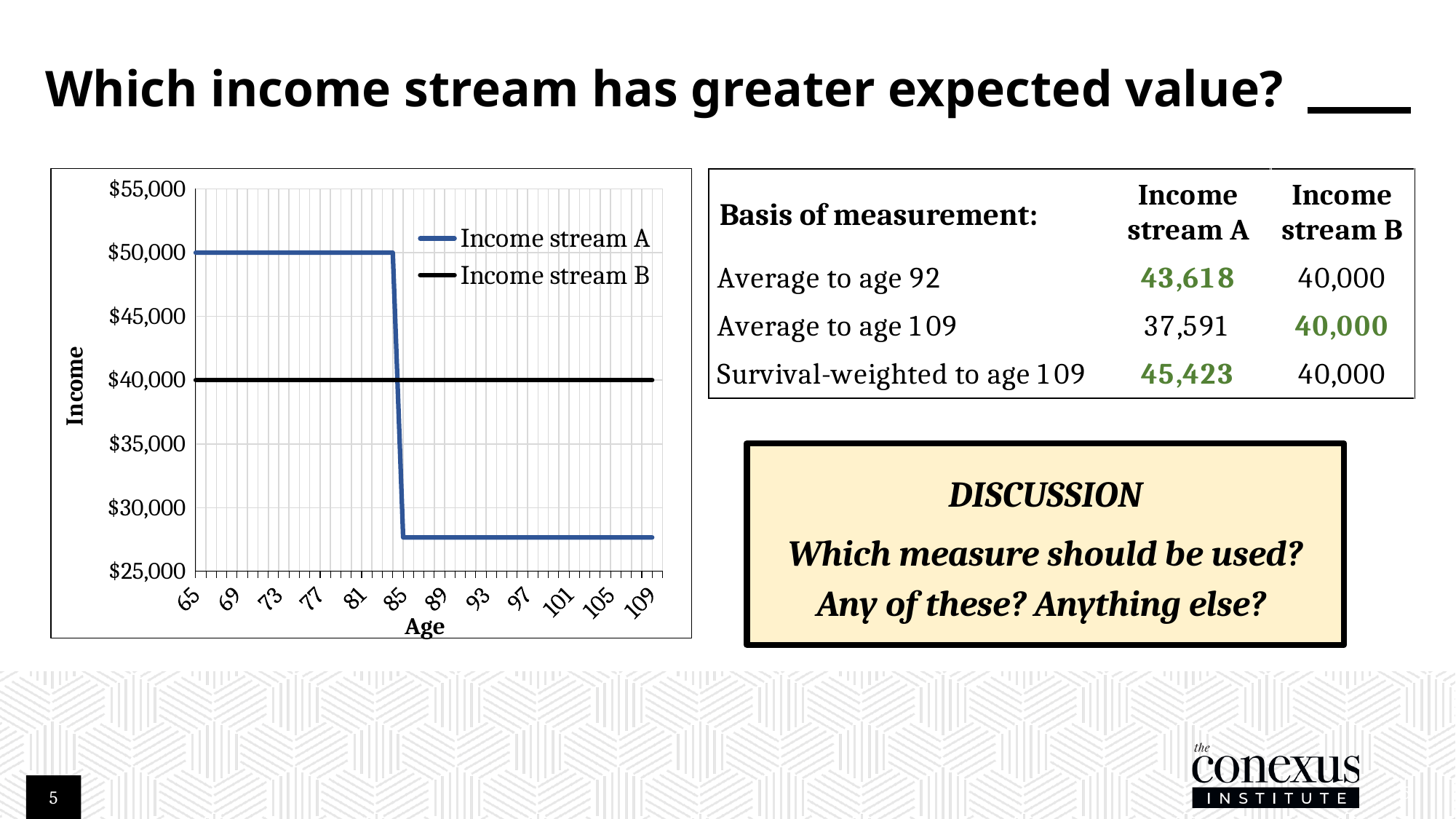
At age 65, what is the difference between Income stream A and Income stream B? $10,000 Is the value for Income stream A at age 75 greater or less than $45,000? greater How many series does the chart legend list? 2 What are the titles of the x axis and y axis of the chart? Age and Income What kind of chart is shown on the slide? line chart Is the value for Income stream A at age 100 greater or less than $30,000? less At age 70, which series has the larger value, Income stream A or Income stream B? Income stream A What is the value of Income stream B across all ages in the chart? $40,000 What are the two series named in the chart legend? Income stream A and Income stream B What is the value of Income stream A at age 65? $50,000 At age 100, which series has the larger value, Income stream A or Income stream B? Income stream B Does Income stream A rise, fall, or stay flat as age increases along the x axis? fall